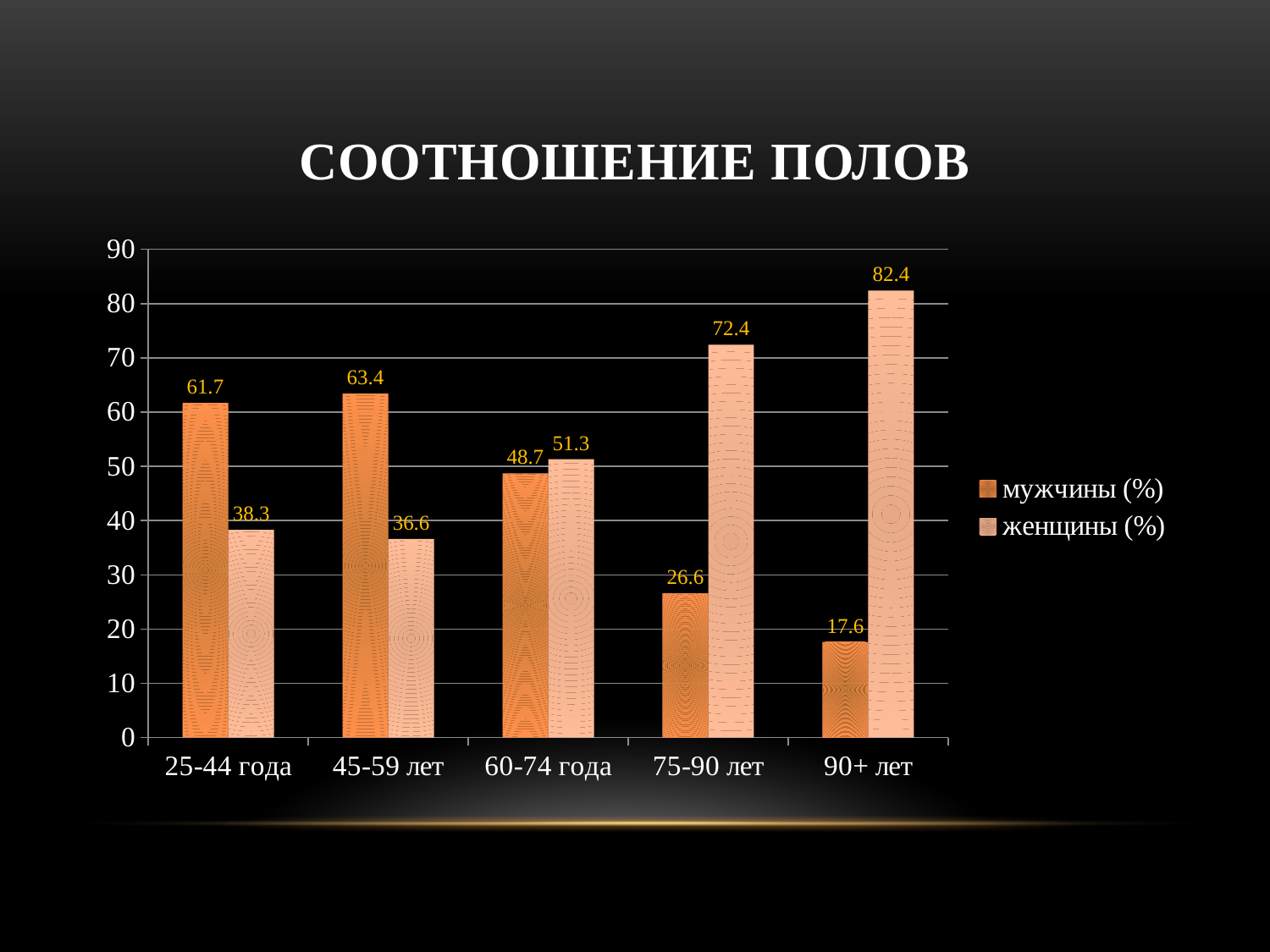
What is the value for женщины (%) in the 60-74 года category? 51.3 What is the value for мужчины (%) in the 25-44 года category? 61.7 How many age categories are shown on the x axis? 5 In the 45-59 лет category, which series has the larger value, мужчины (%) or женщины (%)? мужчины (%) Do the values for мужчины (%) rise or fall from the 45-59 лет category to the 90+ лет category? fall What is the title of the slide? СООТНОШЕНИЕ ПОЛОВ Which age category has the lowest value for мужчины (%)? 90+ лет What is the value for женщины (%) in the 90+ лет category? 82.4 What kind of chart is shown on the slide? bar chart What is the difference between женщины (%) and мужчины (%) in the 75-90 лет category? 45.8 Which age category has the highest value for женщины (%)? 90+ лет How many series does the legend list? 2